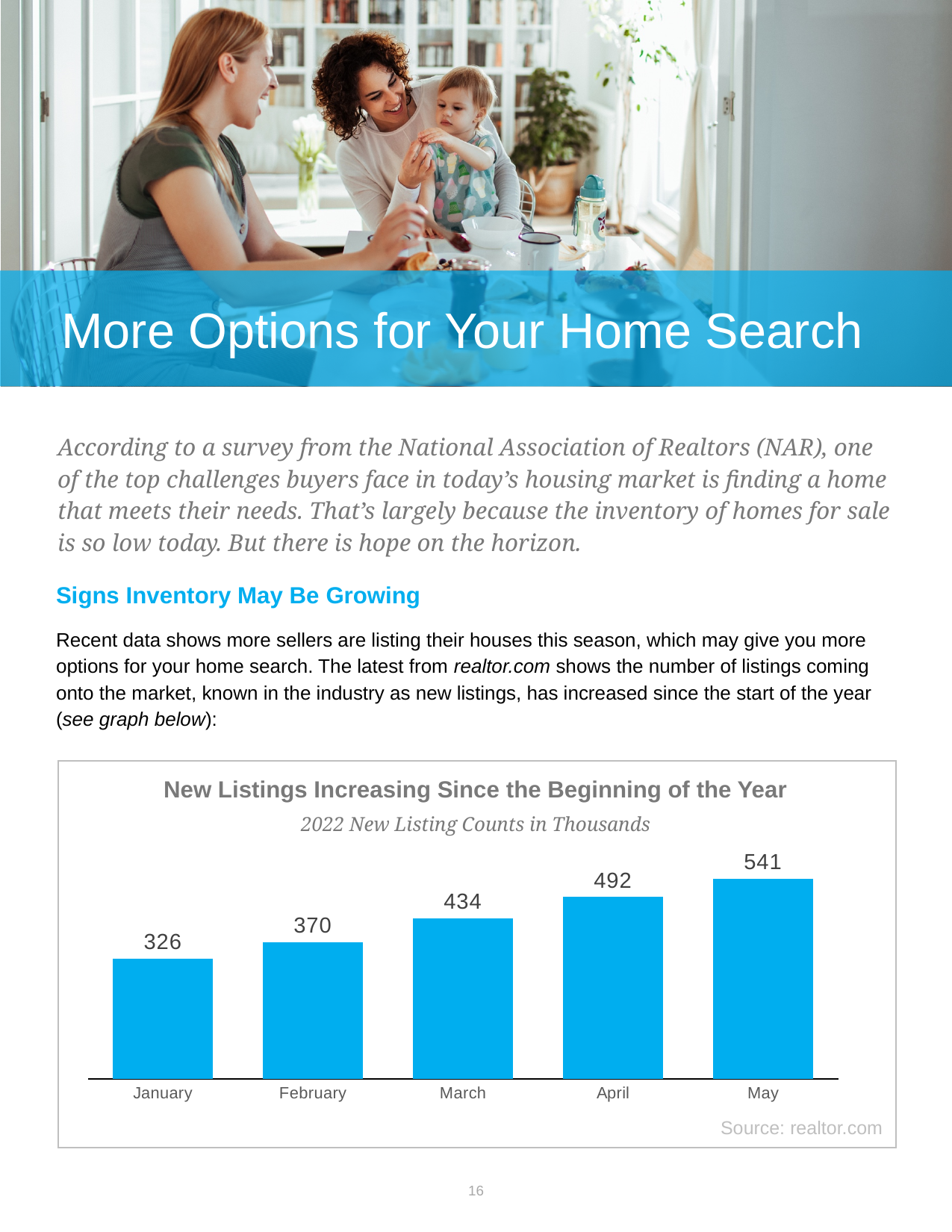
Which month has a larger new listing count, February or April? April Which month has the highest new listing count? May Which month has the lowest new listing count? January What is the title of the chart? New Listings Increasing Since the Beginning of the Year What is the new listing count for May? 541 What is the new listing count for March? 434 What is the difference between the new listing counts for May and January? 215 What is the difference between the new listing counts for April and March? 58 Do the new listing counts rise or fall from January to May? Rise What kind of chart is shown on the slide? Bar chart How many months are shown in the chart? 5 What is the new listing count for January? 326